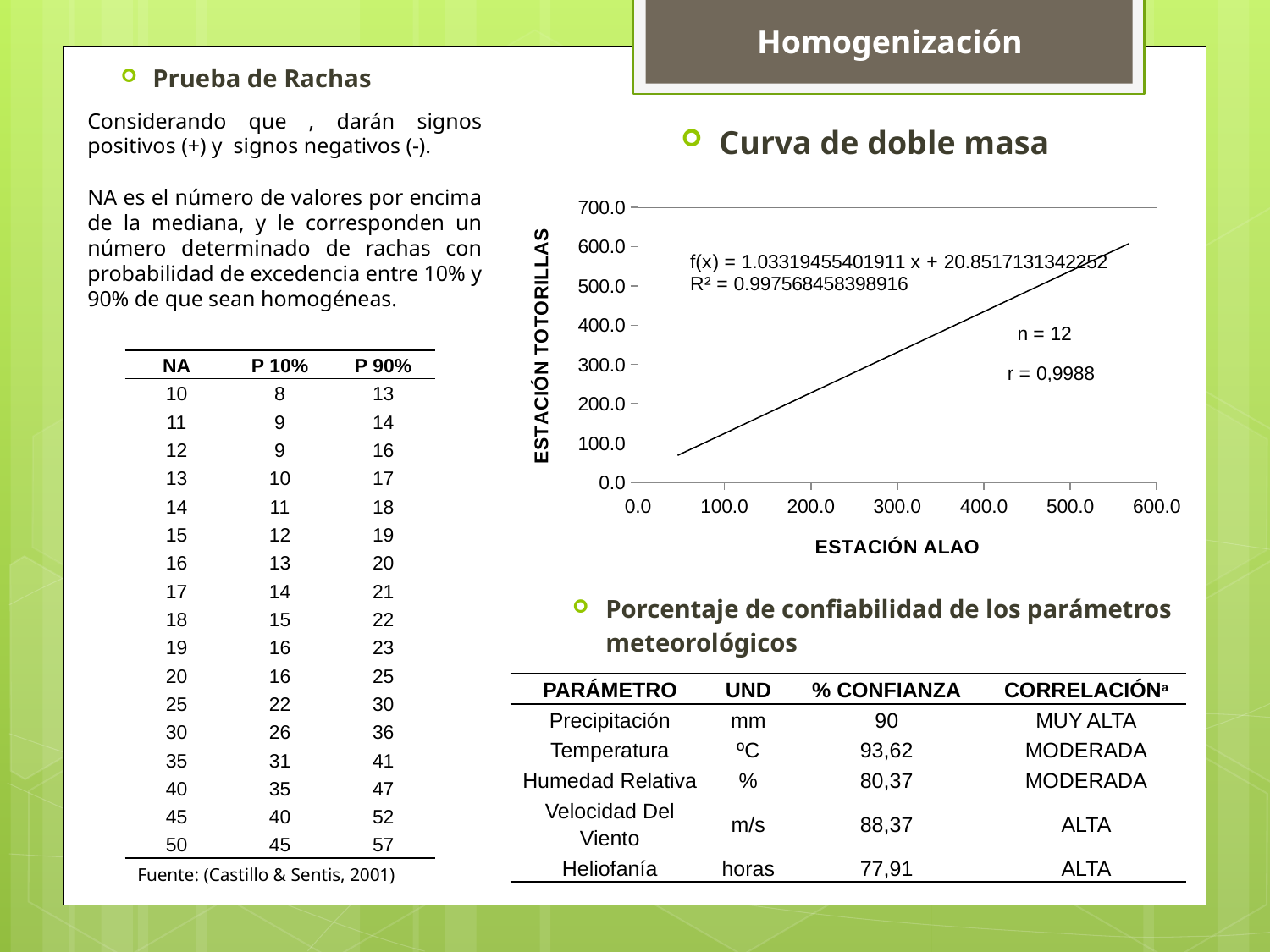
What value of r is shown on the 'Curva de doble masa' chart? r = 0,9988 What is the highest tick value on the horizontal axis of the 'Curva de doble masa' chart? 600.0 What is the label of the vertical axis in the 'Curva de doble masa' chart? ESTACIÓN TOTORILLAS What kind of chart is the 'Curva de doble masa'? line chart What is the fitted equation shown on the 'Curva de doble masa' chart? f(x) = 1.03319455401911 x + 20.8517131342252 What is the highest tick value on the vertical axis of the 'Curva de doble masa' chart? 700.0 What value of n is shown on the 'Curva de doble masa' chart? n = 12 In the 'Curva de doble masa' chart, at ESTACIÓN ALAO = 100.0, is the line's value greater or less than 300.0? less What R² value is printed on the 'Curva de doble masa' chart? R² = 0.997568458398916 In the 'Curva de doble masa' chart, does the line rise or fall as ESTACIÓN ALAO increases? rises In the 'Curva de doble masa' chart, at ESTACIÓN ALAO = 500.0, is the line's value greater or less than 400.0? greater What is the label of the horizontal axis in the 'Curva de doble masa' chart? ESTACIÓN ALAO